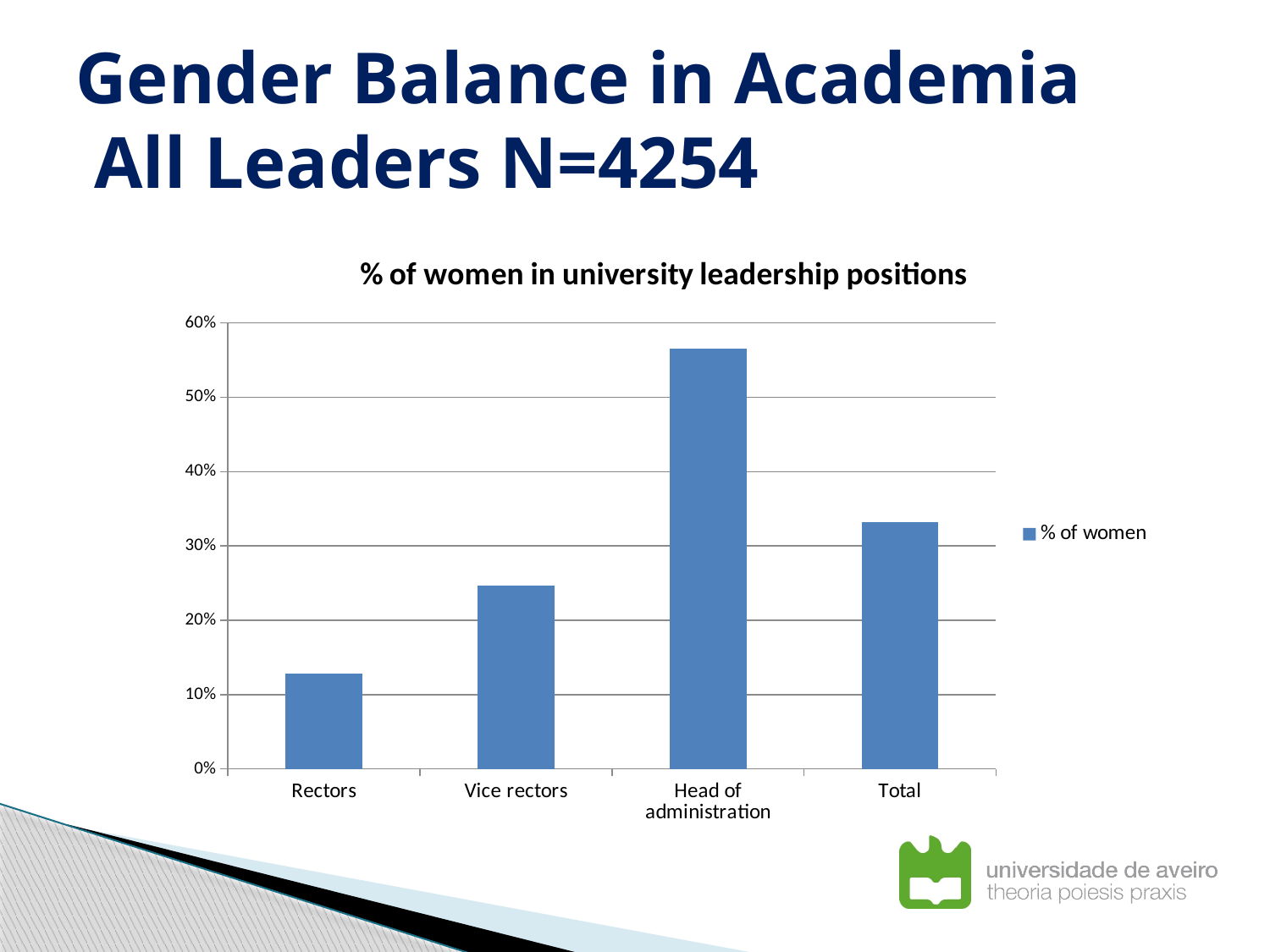
What is the name of the series shown in the legend? % of women What is the title of the chart? % of women in university leadership positions Which is larger, the value for Vice rectors or the value for Total? Total What type of chart is shown on the slide? bar chart Which category has the highest % of women? Head of administration Is the value for Vice rectors greater or less than 30%? less How many categories are shown on the x axis of the chart? 4 Is the value for Head of administration greater or less than 50%? greater Is the value for Total greater or less than 30%? greater Which category has the lowest % of women? Rectors How many series does the chart legend list? 1